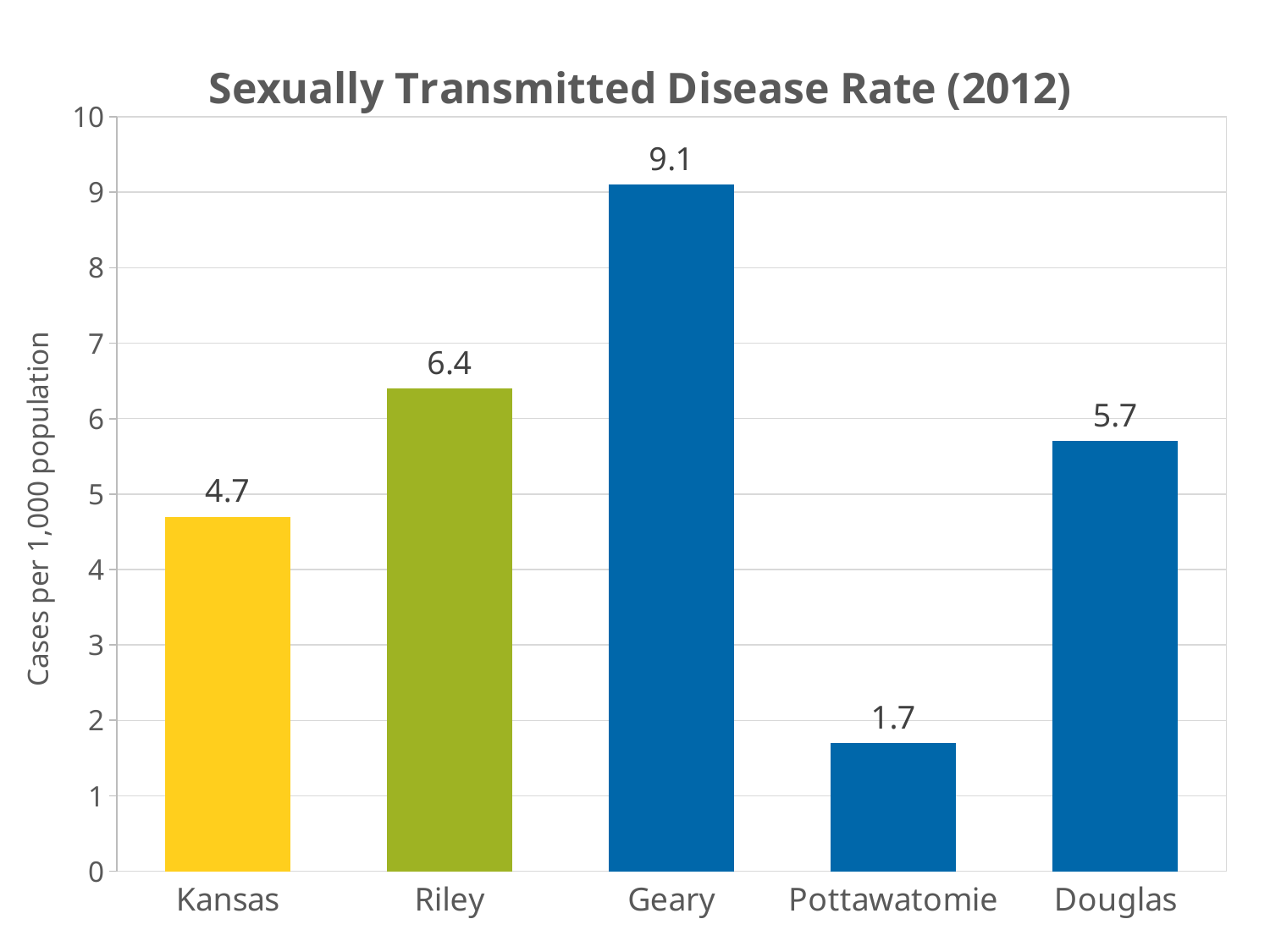
What is the label on the vertical axis? Cases per 1,000 population What is the difference between the rates for Geary and Riley? 2.7 Which category has the lowest rate? Pottawatomie What is the sexually transmitted disease rate for Geary? 9.1 Which category has the highest rate? Geary How many categories are shown on the x axis? 5 Is the value for Douglas greater or less than 5? greater What kind of chart is shown on the slide? Bar chart Which has a higher rate, Riley or Douglas? Riley What is the difference between the rates for Douglas and Kansas? 1.0 What is the value shown for Kansas? 4.7 What is the sexually transmitted disease rate for Pottawatomie? 1.7